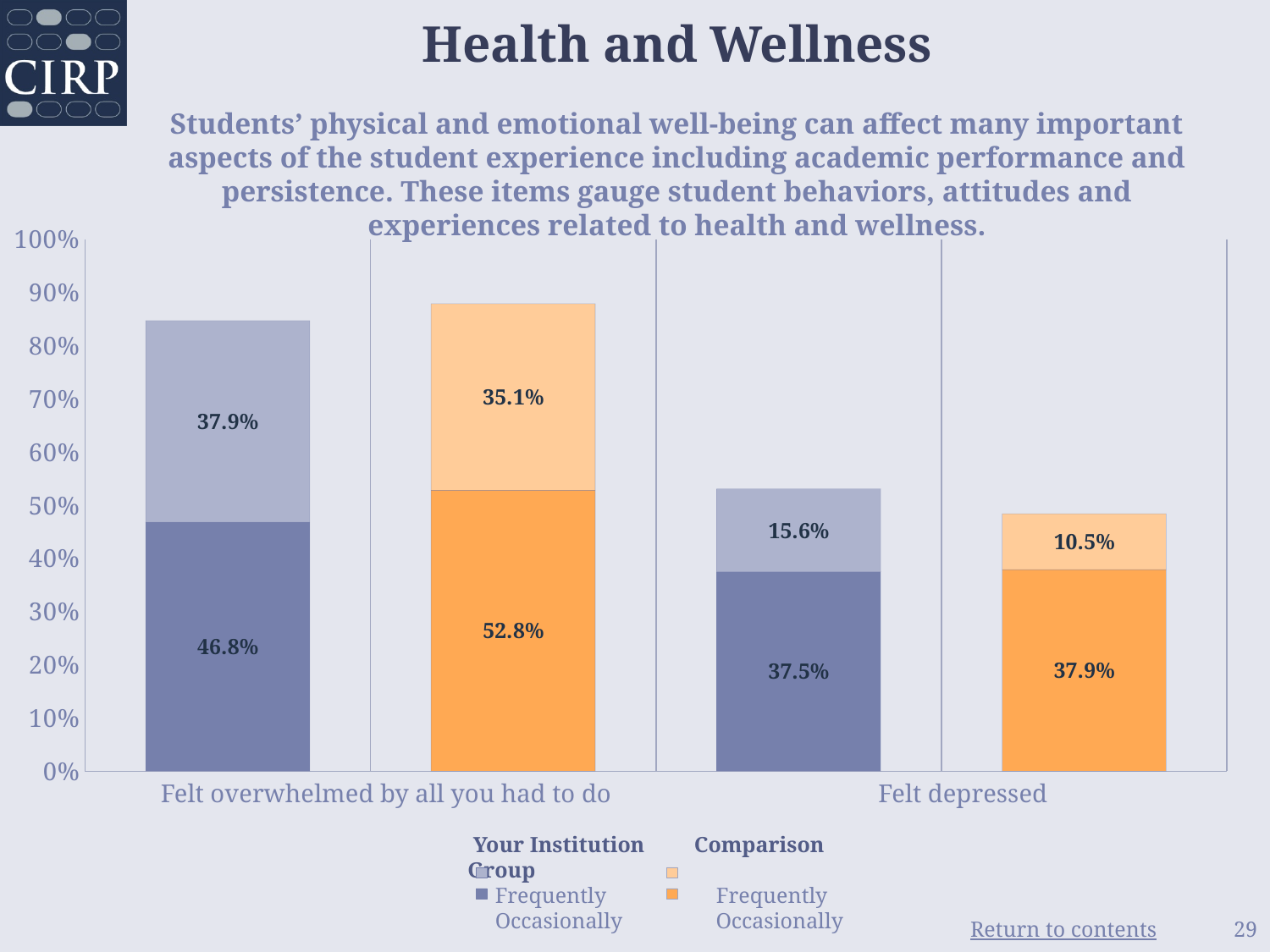
What percentage of students at Your Institution reported occasionally feeling depressed? 37.5% What is the total percentage (frequently plus occasionally) of Your Institution students who felt overwhelmed by all they had to do? 84.7% Which group has the larger percentage of students who occasionally felt depressed, Your Institution or the Comparison Group? Comparison Group What percentage of the Comparison Group reported occasionally feeling depressed? 37.9% What is the difference between the Comparison Group and Your Institution in the percentage who frequently felt overwhelmed by all they had to do? 2.8% Which of the four stacked bars reaches the highest total? Comparison Group, Felt overwhelmed by all you had to do What percentage of students at Your Institution reported frequently feeling overwhelmed by all they had to do? 37.9% Is the total stacked bar for Your Institution for 'Felt depressed' greater or less than 50%? greater What type of chart is shown on the slide? Stacked bar chart What percentage of the Comparison Group reported frequently feeling overwhelmed by all they had to do? 35.1% What is the total percentage (frequently plus occasionally) of the Comparison Group who felt depressed? 48.4% How many item categories are shown on the x axis? 2